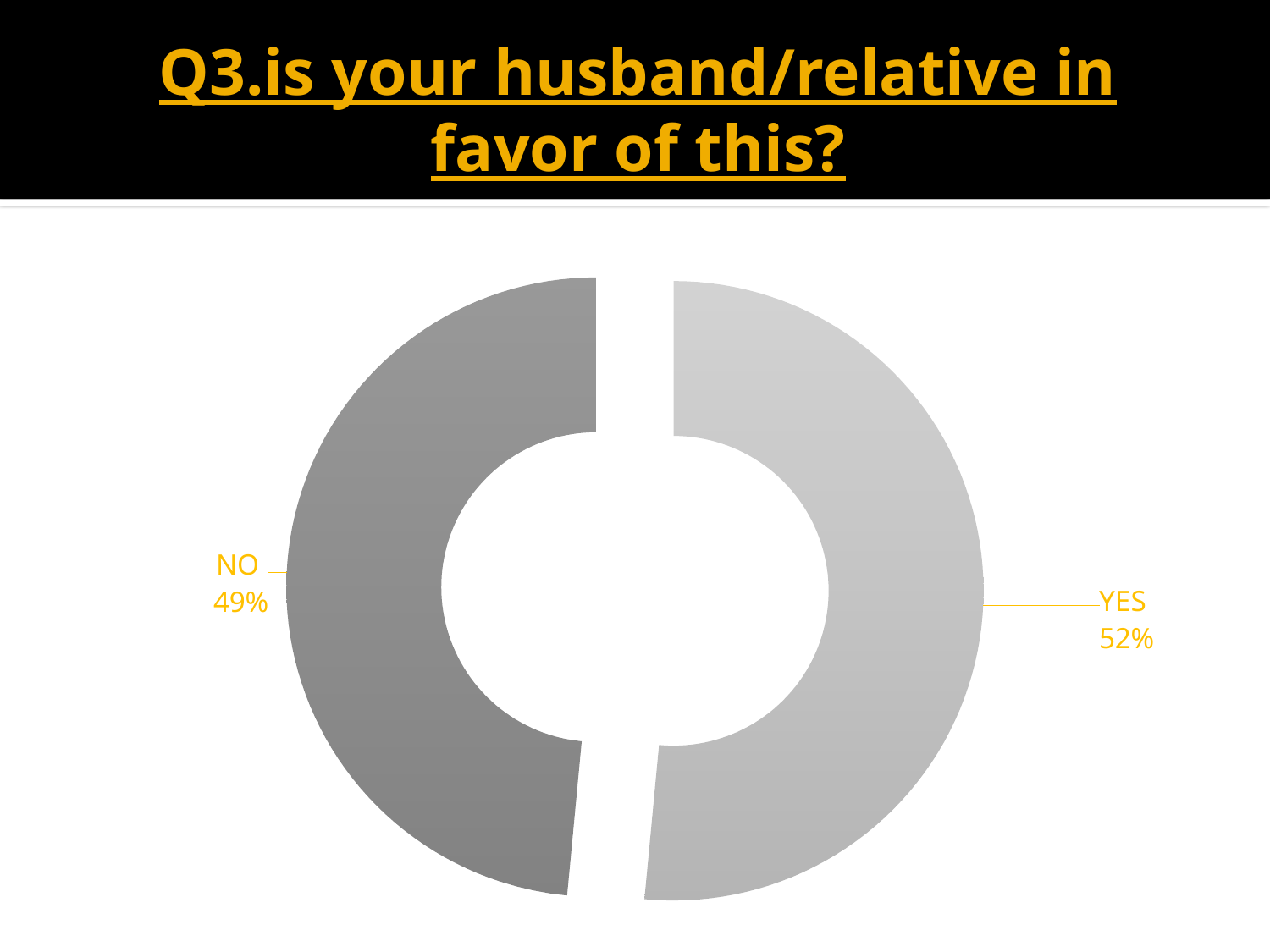
What is the title of the slide? Q3.is your husband/relative in favor of this? Which response has the smaller share of the chart? NO How many response categories are shown in the chart? 2 What share of the chart does the NO slice represent? 49% Is the share for YES larger or smaller than the share for NO? larger Which response has the larger share of the chart? YES What percentage of respondents answered YES? 52% What kind of chart is shown on the slide? doughnut chart Which slice is shown in the darker grey shade? NO By how many percentage points does YES exceed NO? 3 percentage points What percentage of respondents answered NO? 49%